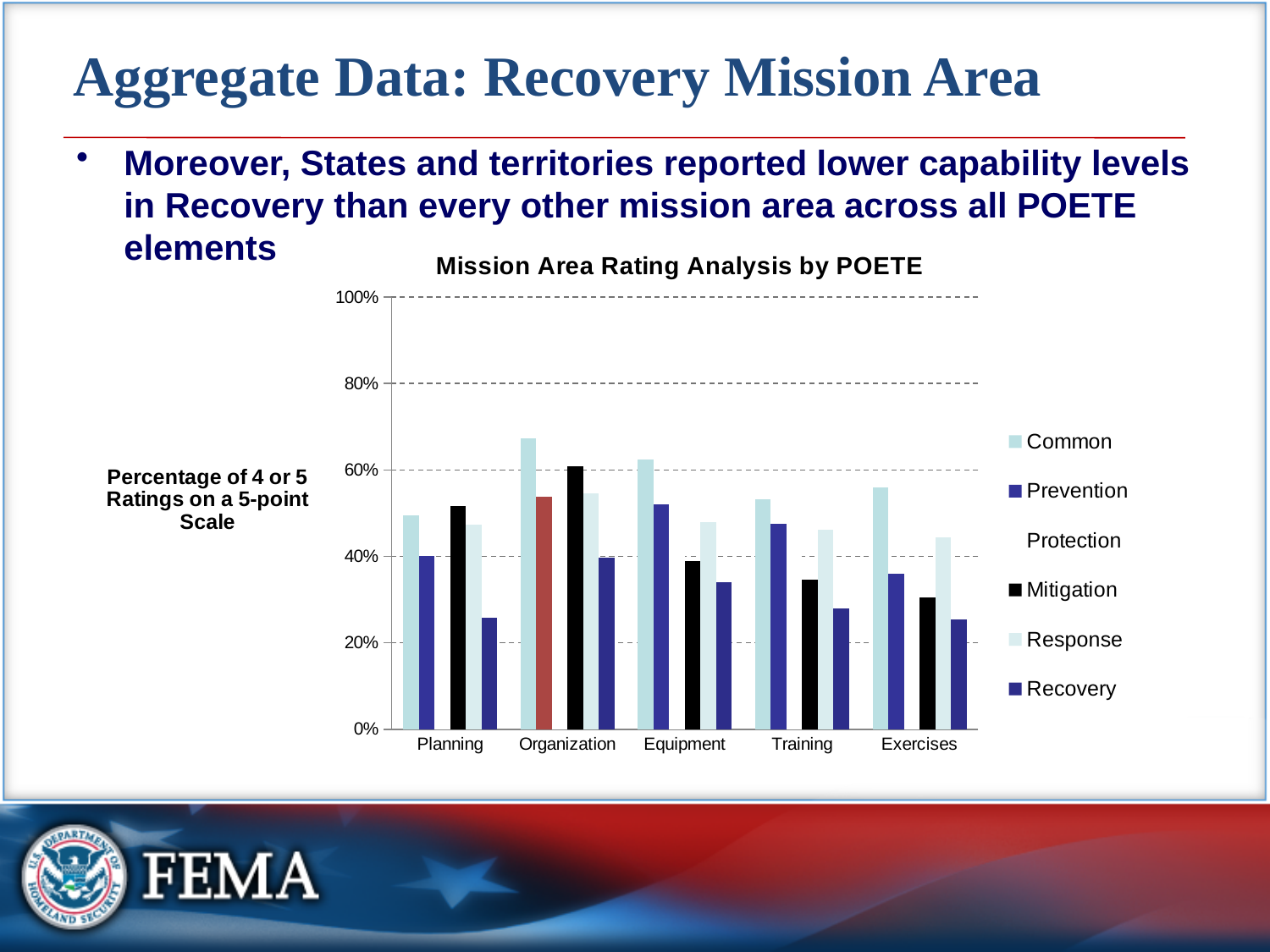
For which POETE category is the Mitigation series highest? Organization What is the title of the chart? Mission Area Rating Analysis by POETE For Planning, which is larger: the Mitigation value or the Prevention value? Mitigation For which POETE category is the Common series highest? Organization How many series does the legend list? 6 Is the Recovery value for Planning greater or less than 40%? less Is the Prevention value for Equipment greater or less than 40%? greater Is the Common value for Organization greater or less than 60%? greater How many POETE categories are shown along the x axis? 5 What type of chart is shown on the slide? bar chart For Training, which is larger: the Common value or the Response value? Common